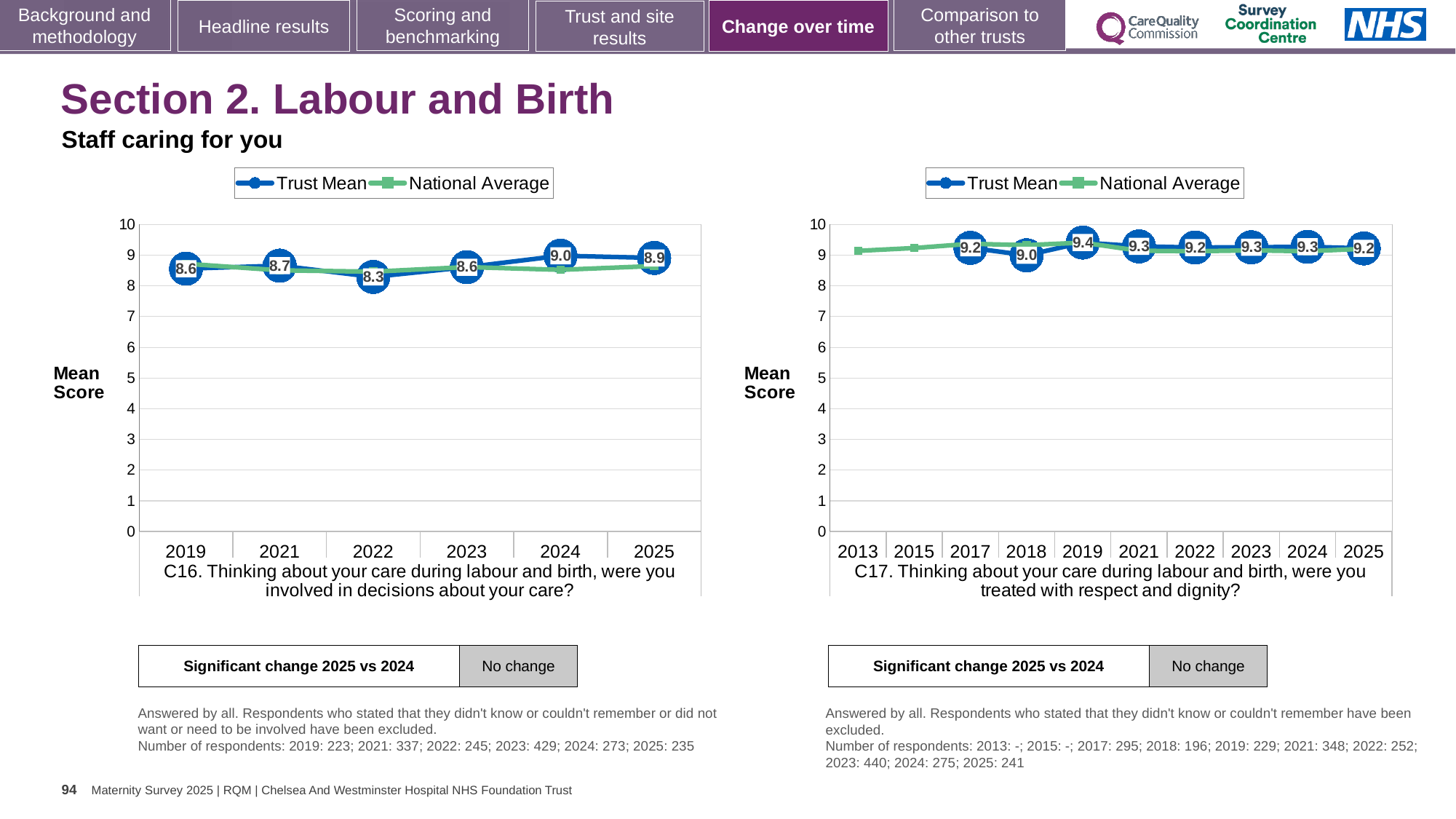
On the C16 chart (left), how many years are shown on the x axis? 6 On the C16 chart (left), what is the Trust Mean for 2024? 9.0 On the C16 chart (left), what is the difference between the Trust Mean for 2024 and 2022? 0.7 What type of chart is the C16 chart (left)? line chart On the C17 chart (right), is the Trust Mean for 2019 larger or smaller than the Trust Mean for 2018? larger On the C16 chart (left), what is the Trust Mean for 2022? 8.3 On the C17 chart (right), which year has the lowest Trust Mean? 2018 On the C17 chart (right), what is the Trust Mean for 2018? 9.0 On the C16 chart (left), which year has the highest Trust Mean? 2024 On the C17 chart (right), how many series does the legend list? 2 On the C17 chart (right), what is the Trust Mean for 2019? 9.4 On the C16 chart (left), which year has the lowest Trust Mean? 2022